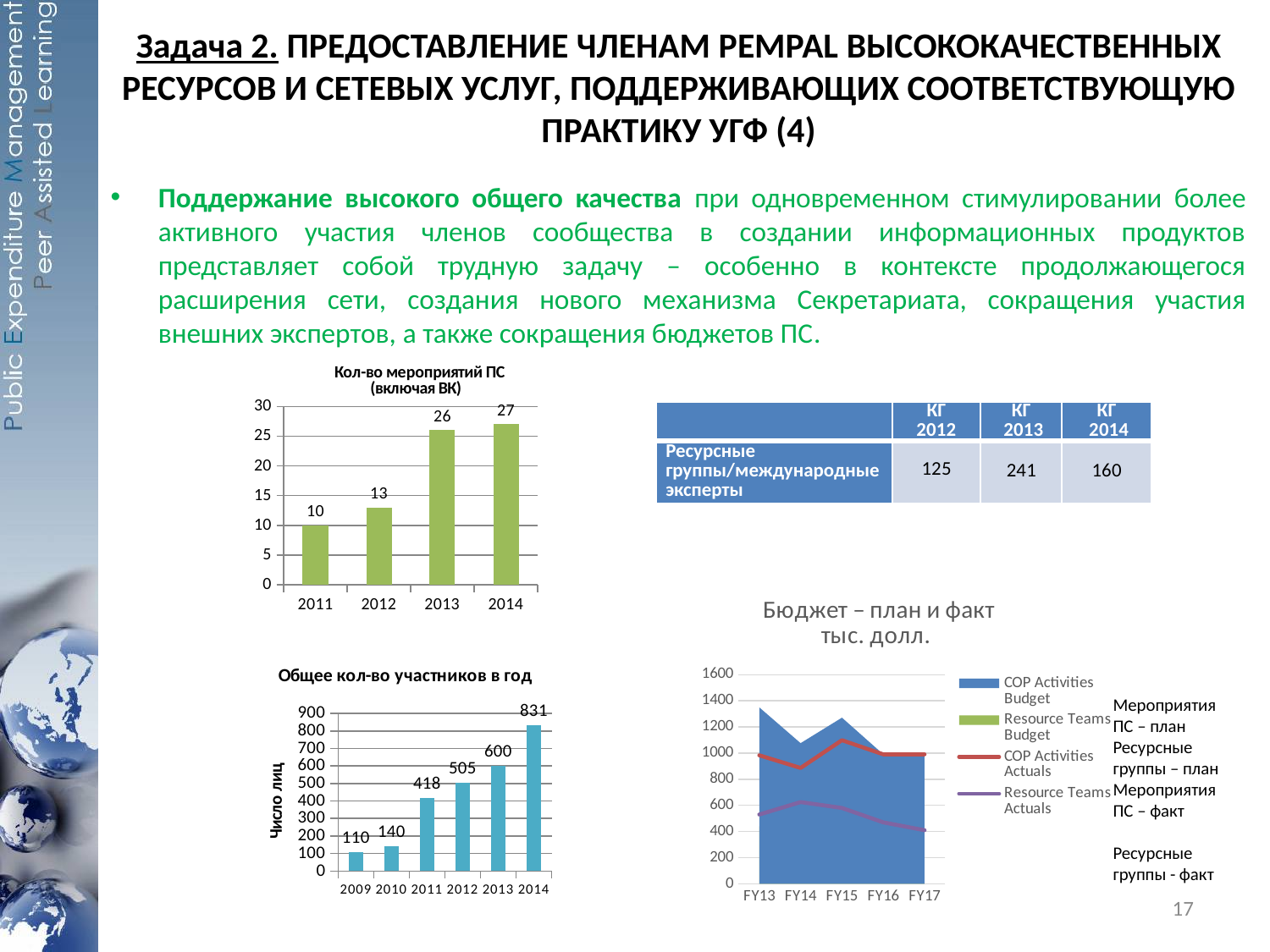
What type of chart is 'Общее кол-во участников в год'? bar chart In the chart 'Общее кол-во участников в год', which year has the highest value? 2014 How many years are shown in the chart 'Кол-во мероприятий ПС (включая ВК)'? 4 In the chart 'Бюджет – план и факт тыс. долл.', is the value of COP Activities Actuals for FY14 greater or less than 1000? less In the chart 'Общее кол-во участников в год', do the values rise or fall from 2009 to 2014? rise In the chart 'Кол-во мероприятий ПС (включая ВК)', what is the difference between the values for 2013 and 2012? 13 In the chart 'Кол-во мероприятий ПС (включая ВК)', which year has the lowest value? 2011 In the chart 'Общее кол-во участников в год', what is the value for 2012? 505 What is the y-axis title of the chart 'Общее кол-во участников в год'? Число лиц How many series does the legend of the chart 'Бюджет – план и факт тыс. долл.' list? 4 In the chart 'Кол-во мероприятий ПС (включая ВК)', what is the value for 2013? 26 In the chart 'Общее кол-во участников в год', what is the difference between the values for 2014 and 2013? 231